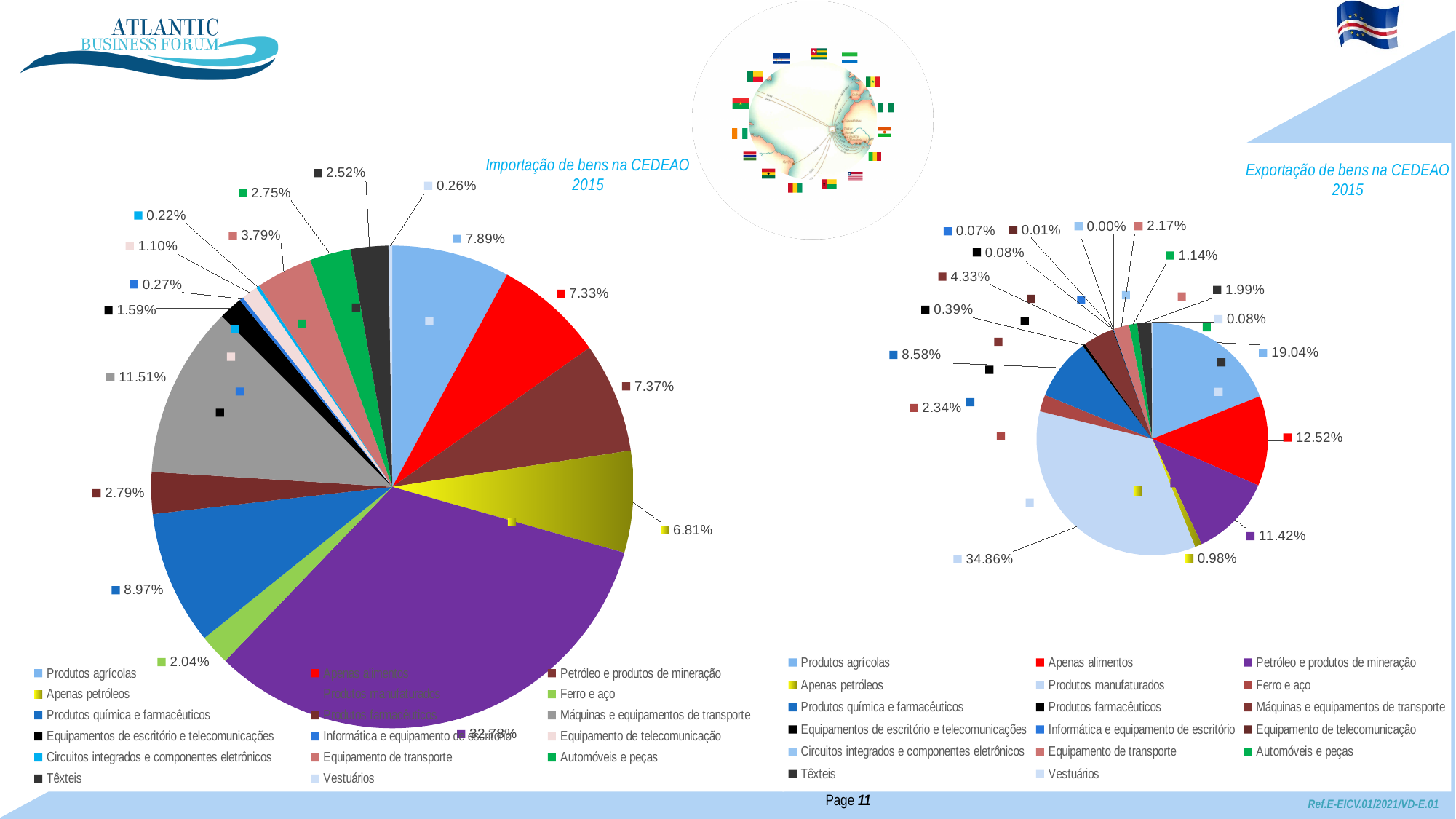
In the 'Importação de bens na CEDEAO 2015' chart, what is the share for Produtos manufaturados? 32.78% In the 'Exportação de bens na CEDEAO 2015' chart, what is the share for Produtos manufaturados? 34.86% In the 'Exportação de bens na CEDEAO 2015' chart, which is larger: Produtos agrícolas or Petróleo e produtos de mineração? Produtos agrícolas In the 'Importação de bens na CEDEAO 2015' chart, what is the share for Apenas alimentos? 7.33% In the 'Importação de bens na CEDEAO 2015' chart, what is the share for Produtos agrícolas? 7.89% In the 'Importação de bens na CEDEAO 2015' chart, what is the share for Máquinas e equipamentos de transporte? 11.51% How many categories does the legend of the 'Exportação de bens na CEDEAO 2015' chart list? 17 In the 'Exportação de bens na CEDEAO 2015' chart, which category has the largest share? Produtos manufaturados In the 'Importação de bens na CEDEAO 2015' chart, which category has the largest share? Produtos manufaturados What kind of chart is the 'Importação de bens na CEDEAO 2015' chart? pie chart In the 'Exportação de bens na CEDEAO 2015' chart, what is the share for Produtos agrícolas? 19.04% In the 'Exportação de bens na CEDEAO 2015' chart, what is the share for Apenas alimentos? 12.52%